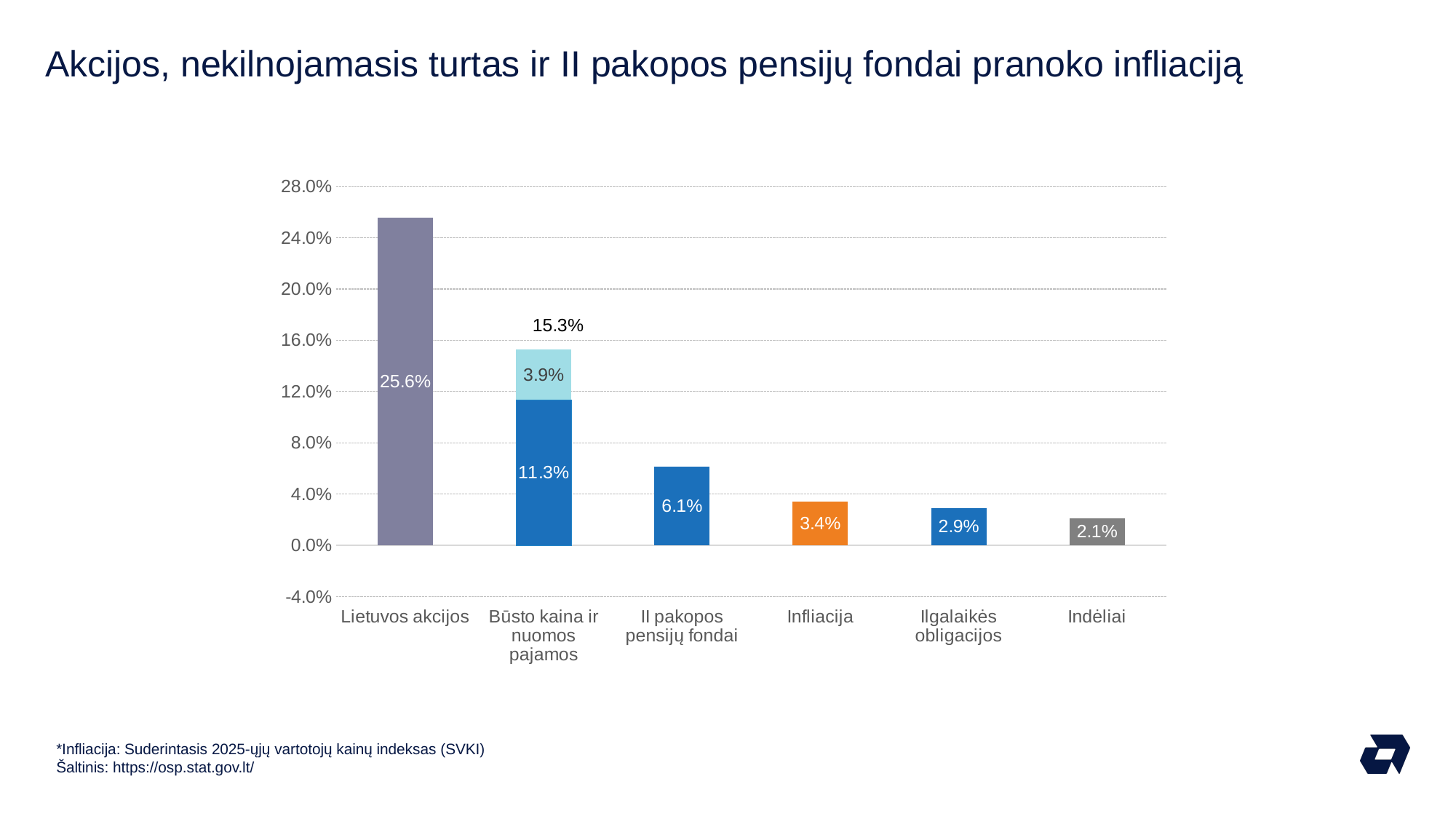
What is the value for Lietuvos akcijos? 25.6% Which category has the lowest value? Indėliai What kind of chart is shown on the slide? Bar chart What is the difference between the values for II pakopos pensijų fondai and Infliacija? 2.7% What is the title of the slide? Akcijos, nekilnojamasis turtas ir II pakopos pensijų fondai pranoko infliaciją What is the total of the stacked bar for Būsto kaina ir nuomos pajamos? 15.3% What is the value for Infliacija? 3.4% What is the value for Ilgalaikės obligacijos? 2.9% Which category has the highest value? Lietuvos akcijos Which is larger, the value for Ilgalaikės obligacijos or the value for Infliacija? Infliacija What is the value for Indėliai? 2.1% How many categories are shown on the x axis? 6